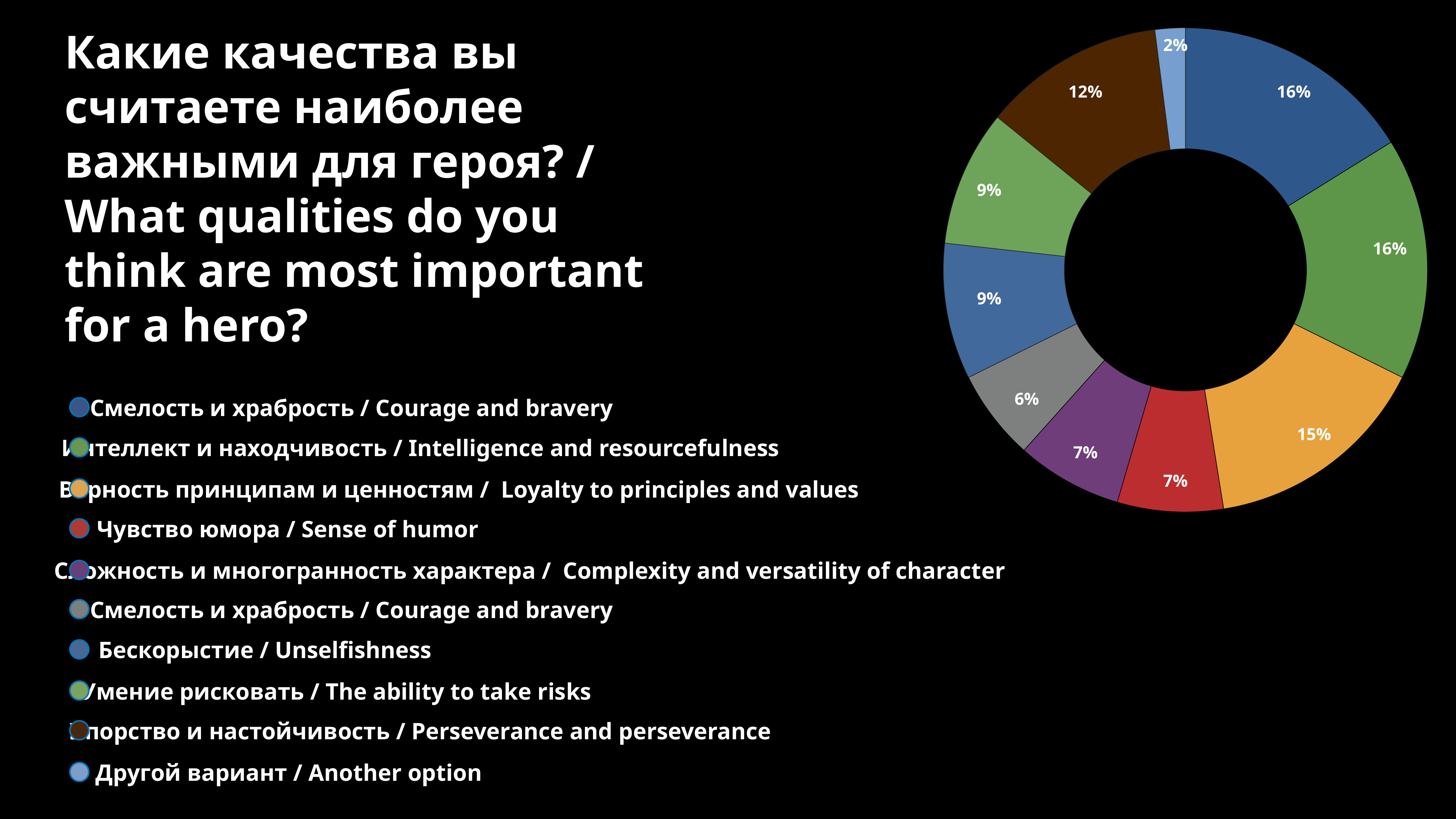
Which has a larger share, Unselfishness or Sense of humor? Unselfishness What share of the chart is labelled for Loyalty to principles and values? 15% What is the difference in percentage points between Intelligence and resourcefulness and The ability to take risks? 7% What percentage is shown for Sense of humor? 7% What type of chart is shown on the slide? Doughnut (pie) chart What percentage is shown for Intelligence and resourcefulness? 16% What is the difference in percentage points between Loyalty to principles and values and Perseverance and perseverance? 3% What percentage is shown for Perseverance and perseverance? 12% How many slices does the chart have? 10 Which category has the smallest slice in the chart? Another option What percentage is shown for Another option? 2% What percentage is shown for Unselfishness? 9%